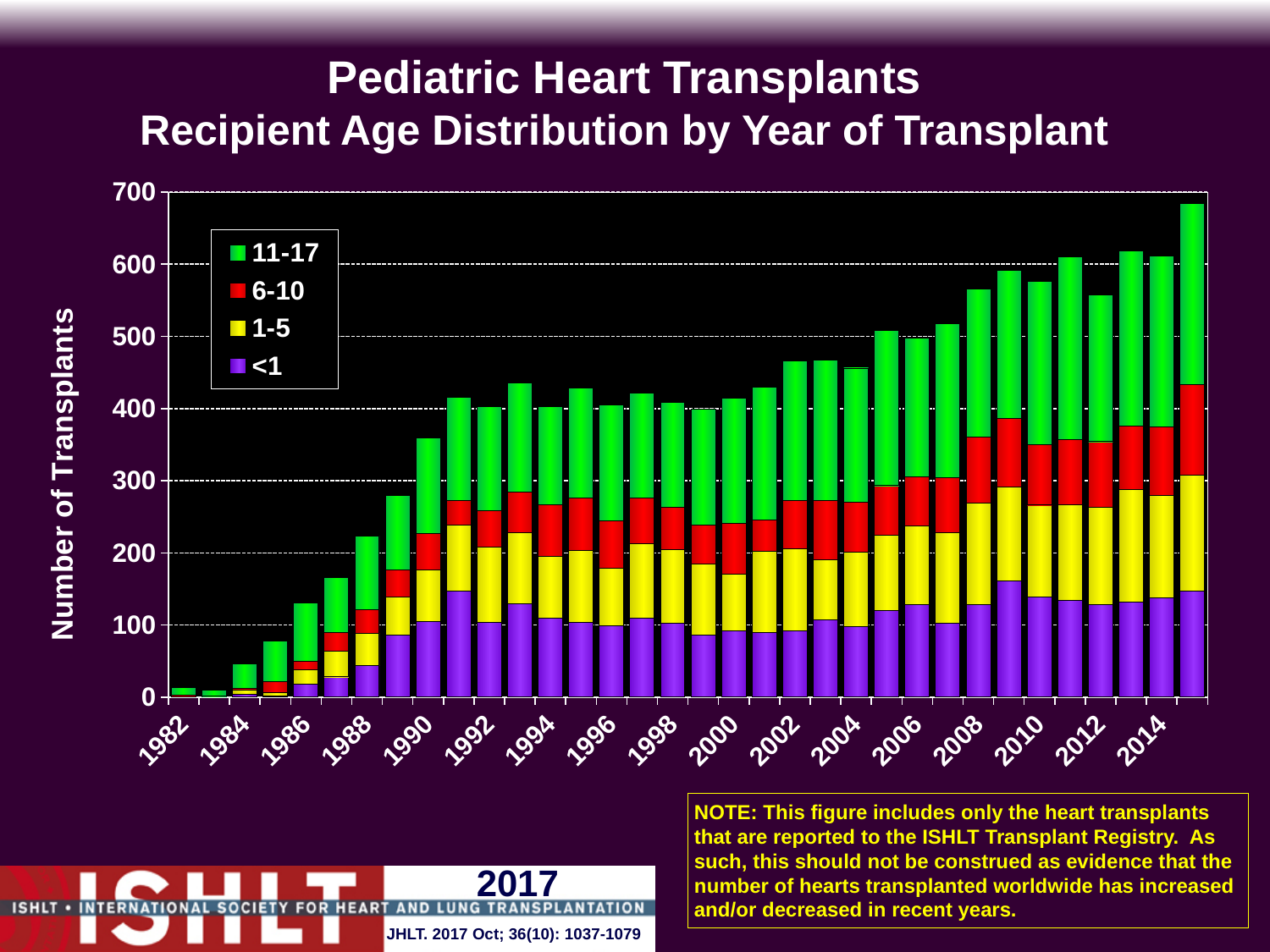
How many series does the legend list? 4 Overall, do the total number of transplants rise or fall from 1982 to 2015? rise How many yearly bars are plotted in the chart? 34 Which year has the larger total number of transplants, 1989 or 1990? 1990 Is the total number of transplants in 1982 greater or less than 100? less What kind of chart is shown on the slide? Stacked bar chart What is the title of the y axis? Number of Transplants What are the four age groups listed in the legend? 11-17, 6-10, 1-5, <1 Which year has the highest total number of transplants? 2015 Is the total number of transplants in 2015 greater or less than 600? greater Is the total number of transplants in 2008 greater or less than 500? greater